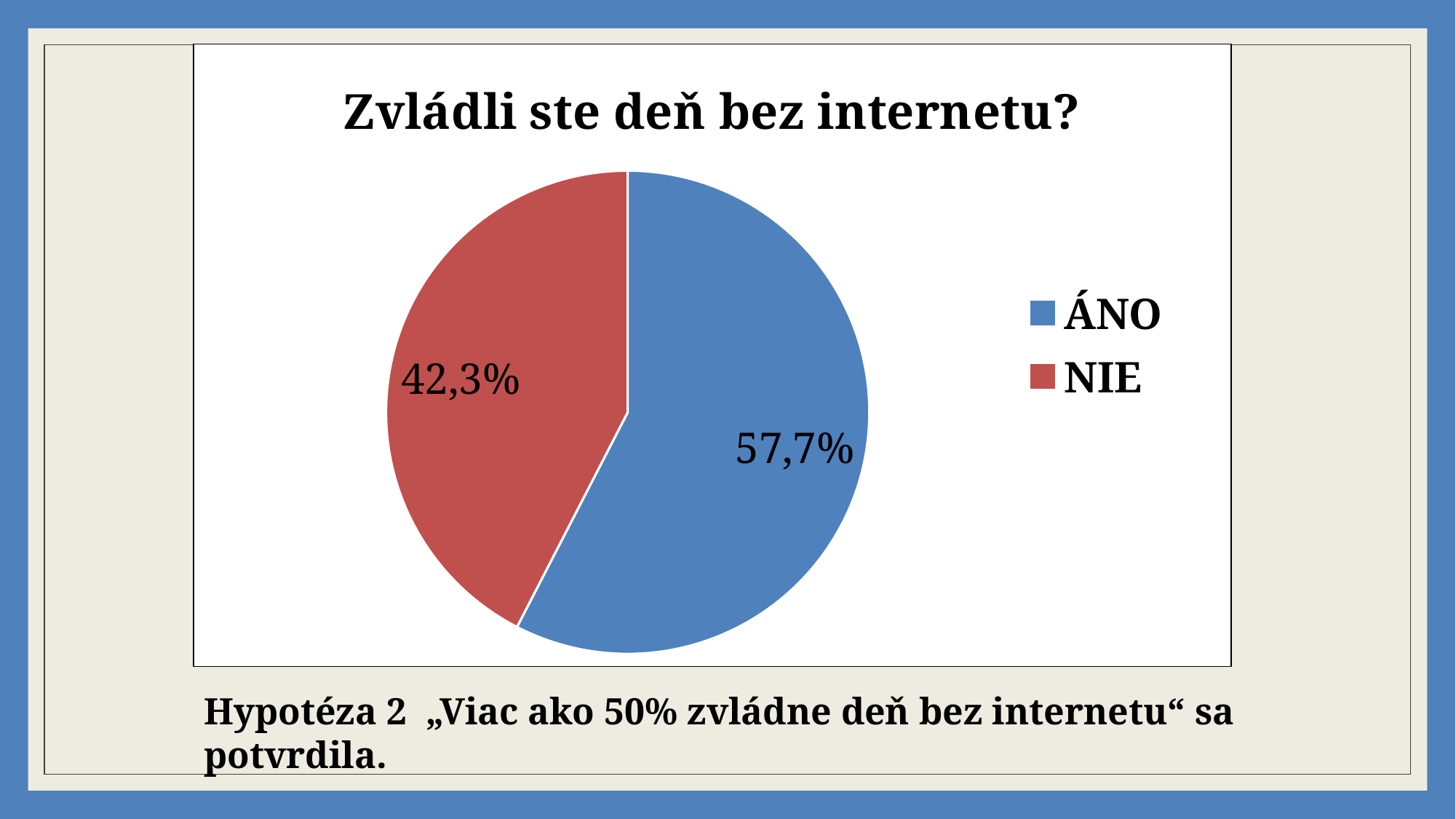
How many entries does the legend list? 2 Which slice is the largest? ÁNO What share of the pie does NIE have? 42,3% How many slices does the pie chart have? 2 Is the share for ÁNO greater or less than 50%? greater What kind of chart is shown on the slide? pie chart Which slice is the smallest? NIE What share of the pie does ÁNO have? 57,7% What is the title of the chart? Zvládli ste deň bez internetu? What is the difference between the ÁNO and NIE shares? 15,4% Which is larger, ÁNO or NIE? ÁNO What colour is the ÁNO slice? blue